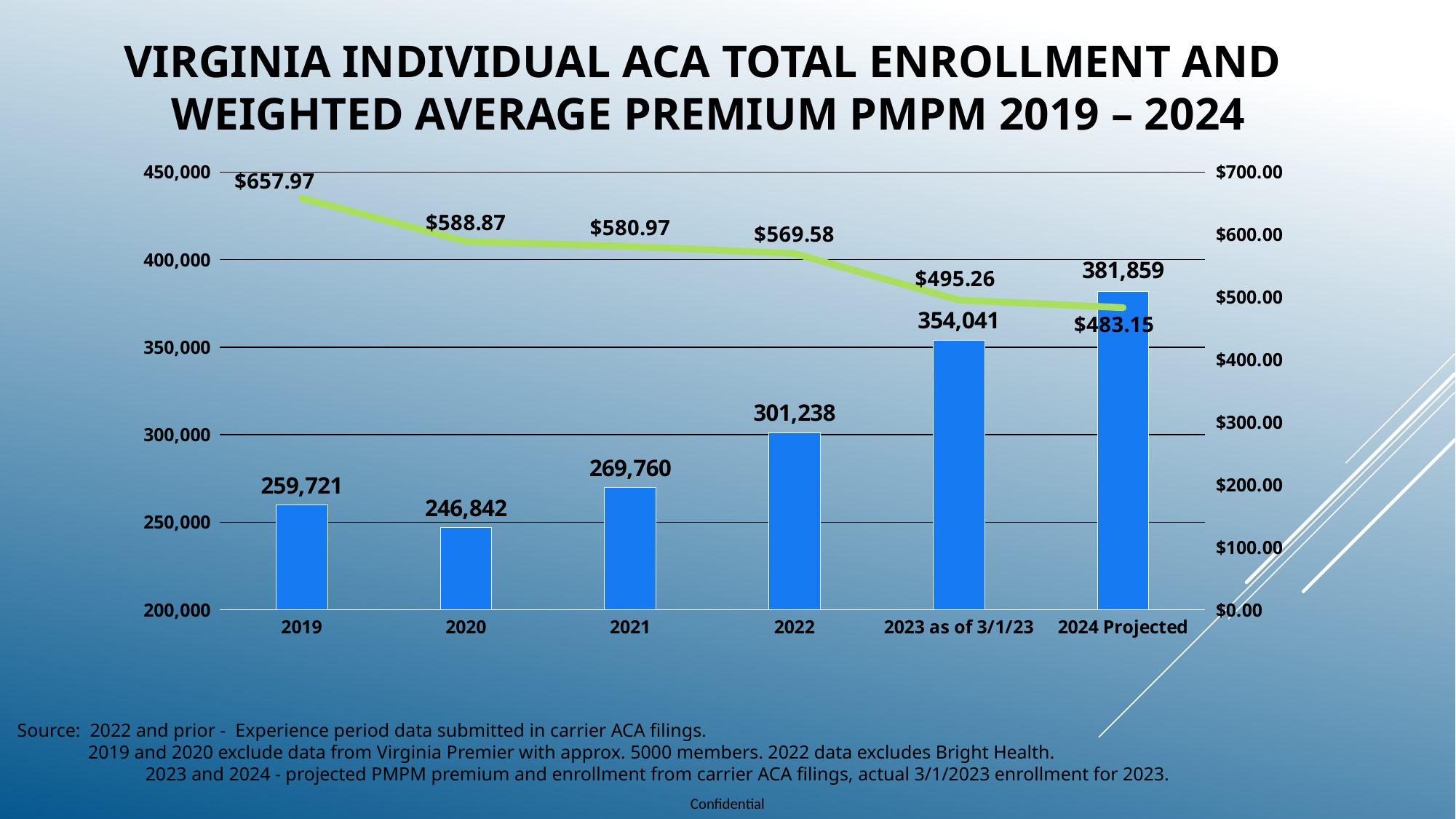
Which year has the highest weighted average premium PMPM? 2019 How much higher is the 2024 Projected enrollment than the 2023 as of 3/1/23 enrollment? 27,818 Does the premium PMPM line rise or fall from 2019 to 2024 Projected? fall By how much did the premium PMPM fall from 2019 to 2020? $69.10 What is the enrollment value labeled for 2024 Projected? 381,859 What is the weighted average premium PMPM shown for 2019? $657.97 What is the total enrollment shown for 2022? 301,238 Which is larger, the enrollment for 2019 or for 2021? 2021 What is the premium PMPM value labeled for 2023 as of 3/1/23? $495.26 Which year has the lowest enrollment bar? 2020 How many years (categories) are shown on the x axis? 6 What colour is the premium PMPM line? green